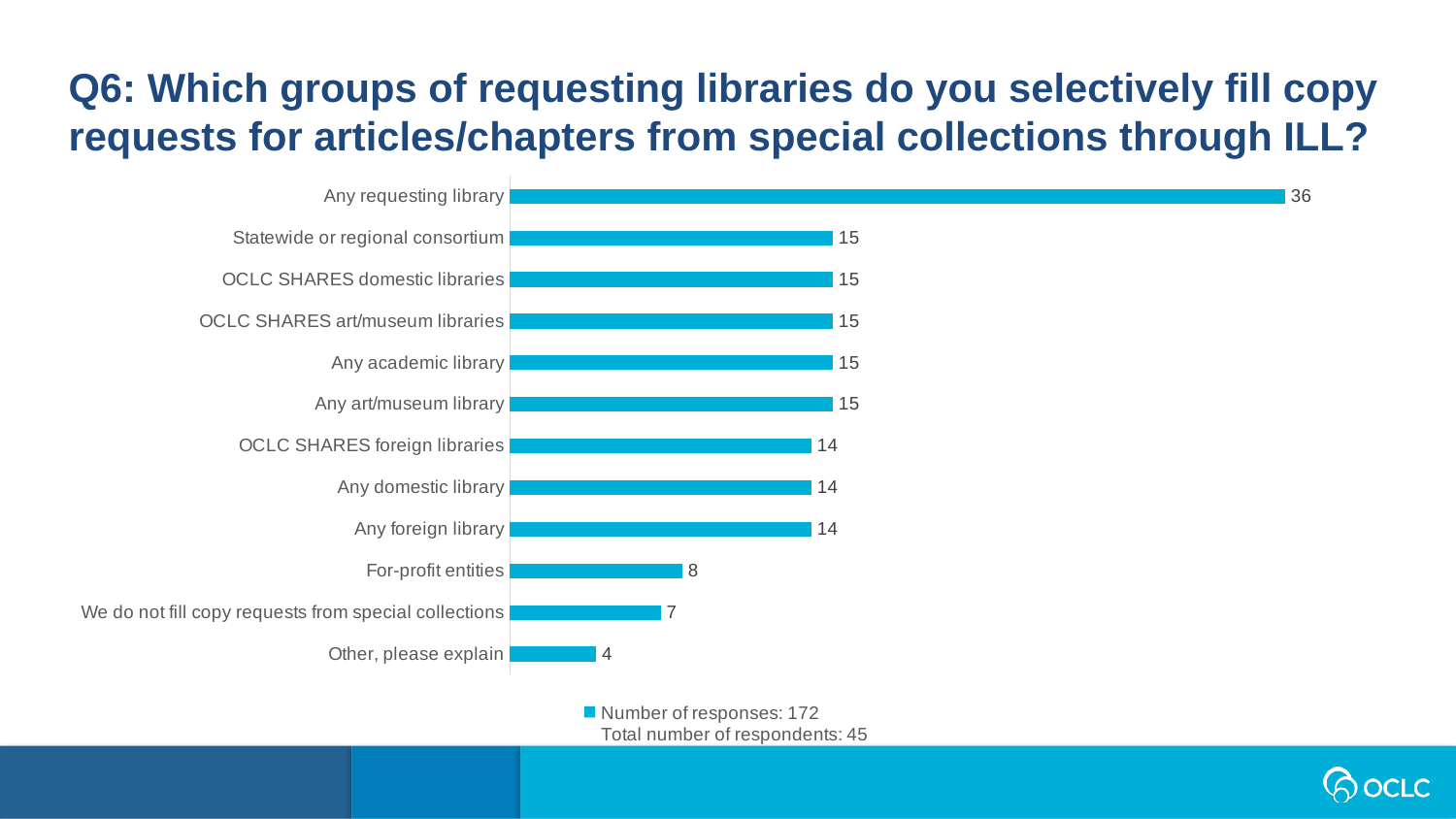
What is the value for 'For-profit entities'? 8 What is the value for 'OCLC SHARES foreign libraries'? 14 Which category has the highest value? Any requesting library Which category has the lowest value? Other, please explain According to the legend, what is the total number of respondents? 45 What is the value for 'Any requesting library'? 36 What kind of chart is shown on the slide? Bar chart How many categories are shown in the chart? 12 Which is larger: 'Any academic library' or 'Any foreign library'? Any academic library What is the difference between 'For-profit entities' and 'Other, please explain'? 4 What is the value for 'We do not fill copy requests from special collections'? 7 What is the difference between 'Any requesting library' and 'Statewide or regional consortium'? 21